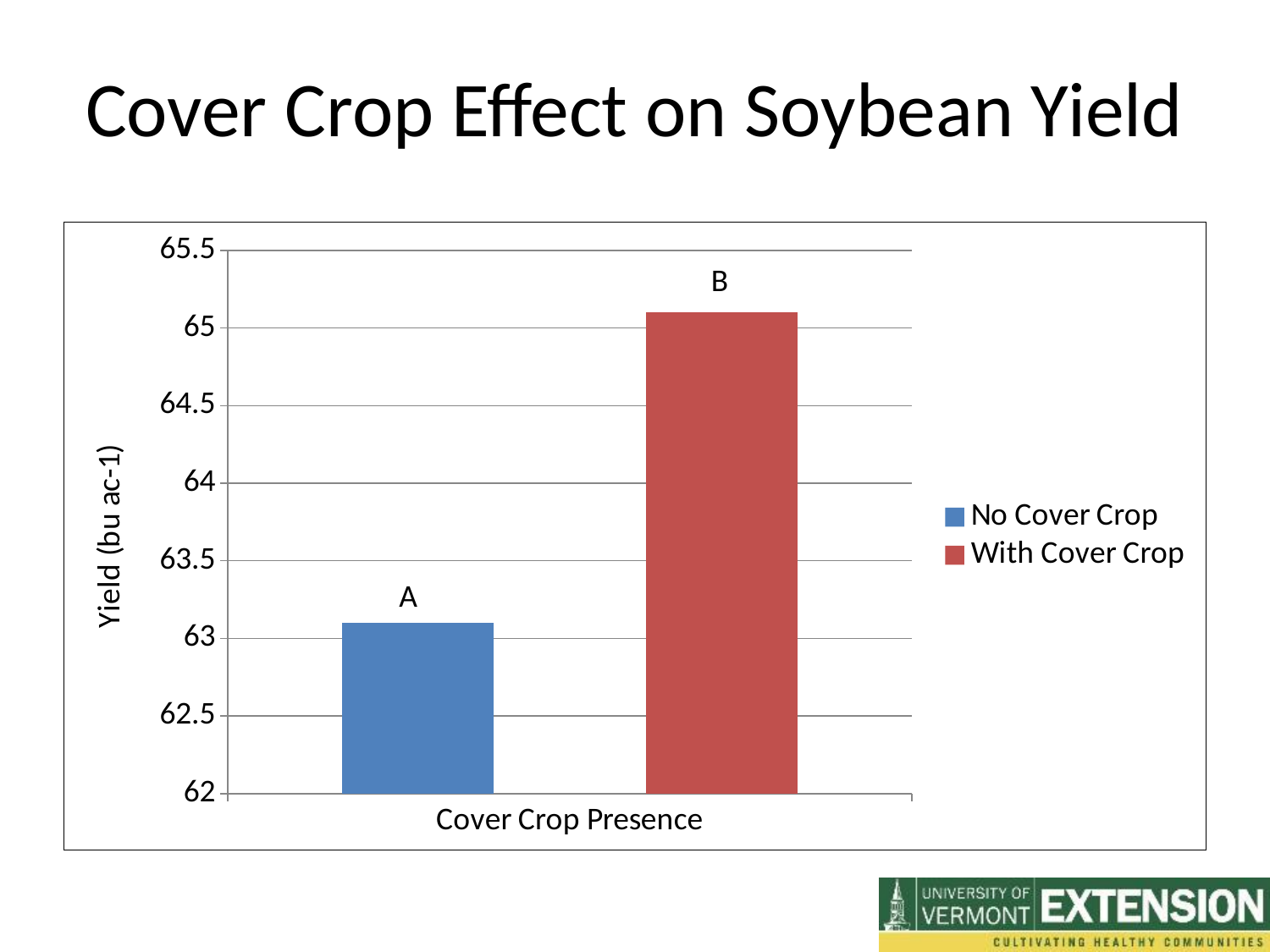
Is the yield for With Cover Crop greater or less than 64.5? greater How many bars are plotted in the chart? 2 What is the label on the vertical axis of the chart? Yield (bu ac-1) Which series has the lowest yield? No Cover Crop Is the yield for With Cover Crop greater or less than 65.5? less Is the yield for No Cover Crop greater or less than 63? greater Which series has the higher yield, No Cover Crop or With Cover Crop? With Cover Crop How many series does the legend list? 2 Which series has the highest yield? With Cover Crop What is the title of the chart on the slide? Cover Crop Effect on Soybean Yield What kind of chart is shown on the slide? bar chart